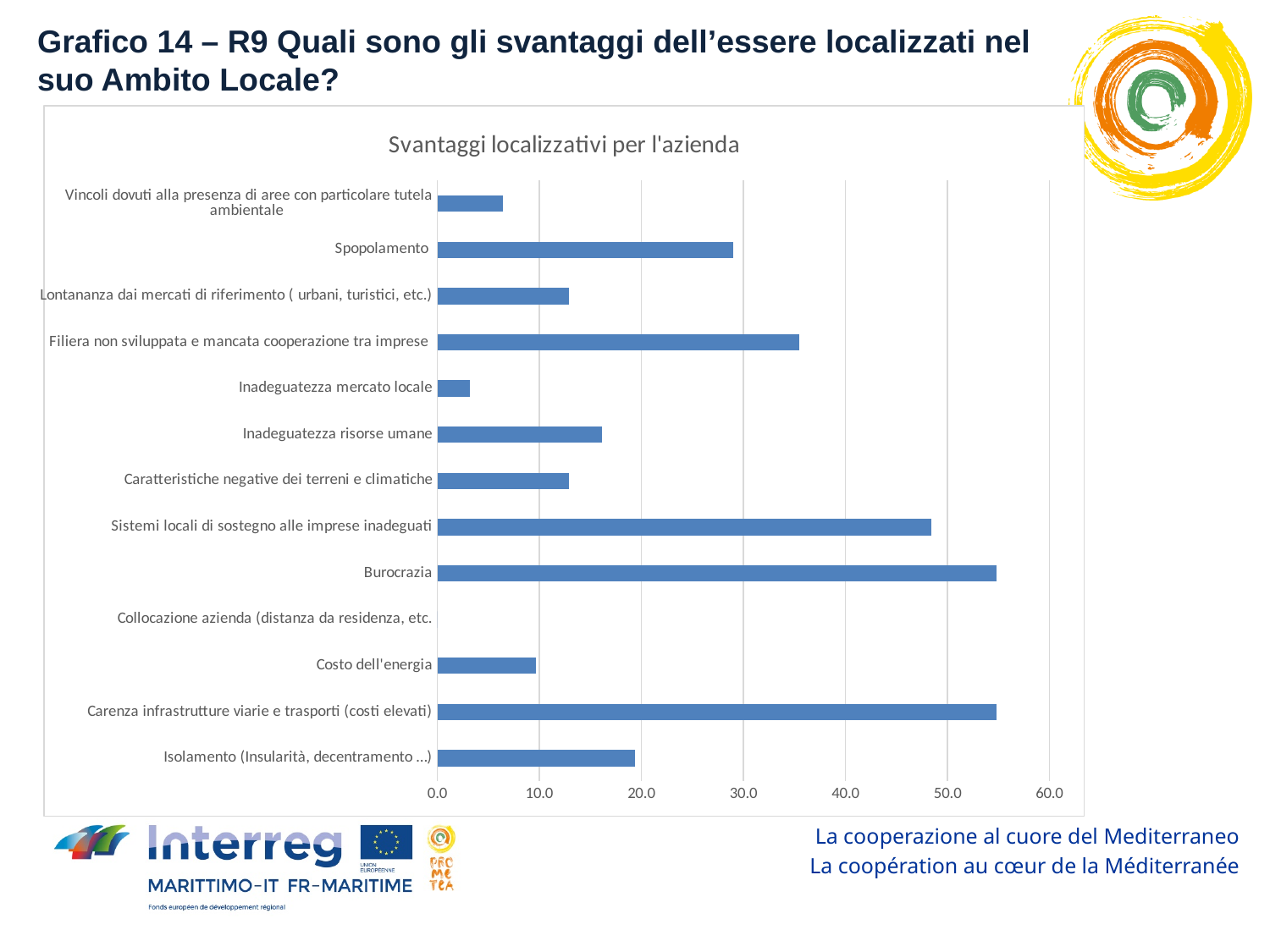
Which has the larger value, Sistemi locali di sostegno alle imprese inadeguati or Filiera non sviluppata e mancata cooperazione tra imprese? Sistemi locali di sostegno alle imprese inadeguati Is the value for Spopolamento greater or less than 20.0? greater Is the value for Burocrazia greater or less than 50.0? greater Is the value for Filiera non sviluppata e mancata cooperazione tra imprese greater or less than 30.0? greater How many categories are listed on the vertical axis of the chart? 13 What is the title of the chart? Svantaggi localizzativi per l'azienda Which has the larger value, Spopolamento or Isolamento (Insularità, decentramento ...)? Spopolamento What kind of chart is shown on the slide? bar chart Which category has the shortest visible bar in the chart? Inadeguatezza mercato locale